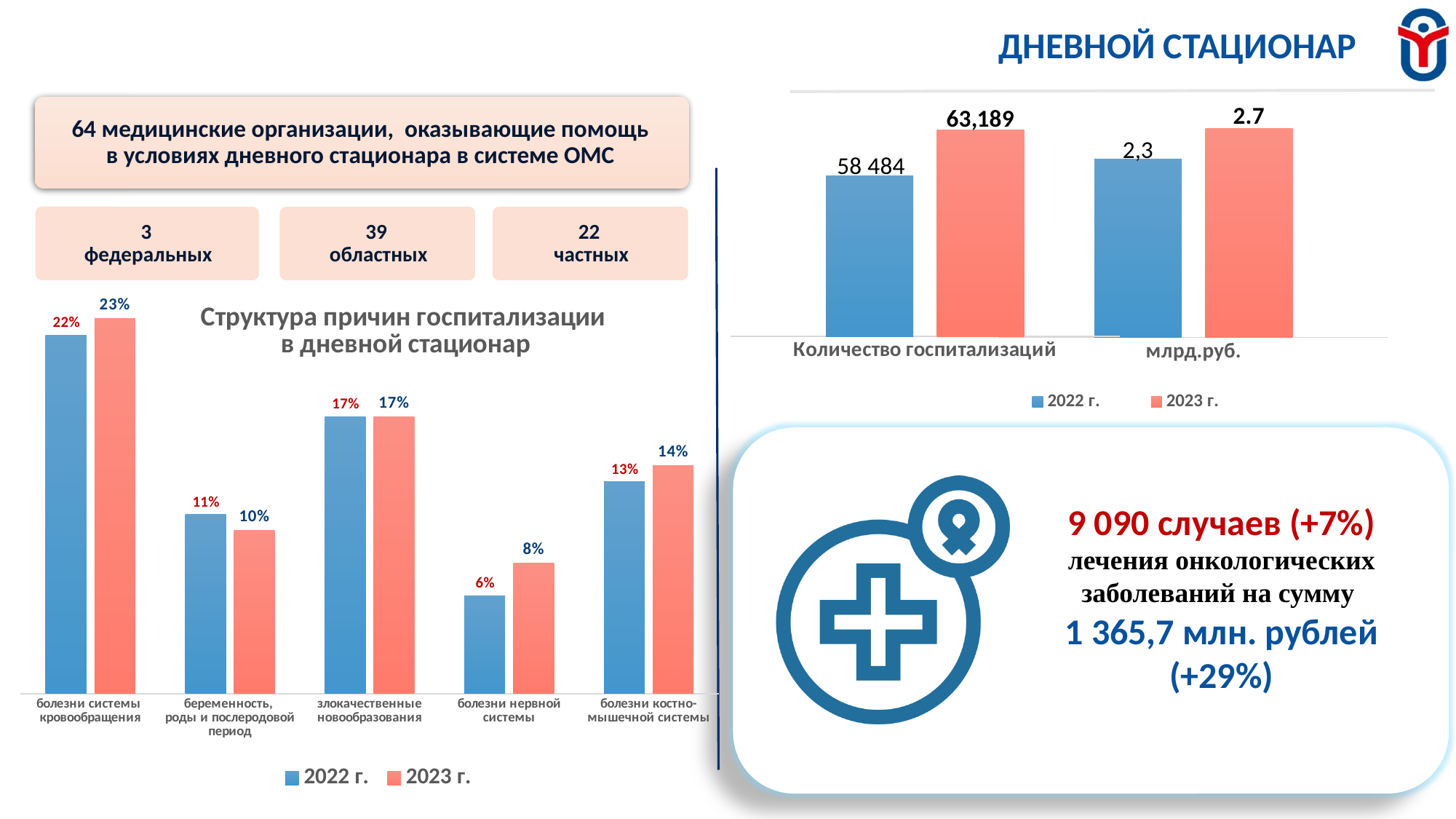
In the chart 'Структура причин госпитализации в дневной стационар', which category has the lowest 2022 г. value? болезни нервной системы In the chart 'Структура причин госпитализации в дневной стационар', which category has the highest 2023 г. value? болезни системы кровообращения How many categories are shown in the chart 'Структура причин госпитализации в дневной стационар'? 5 How many series does the legend list in the chart 'Структура причин госпитализации в дневной стационар'? 2 In the chart 'Структура причин госпитализации в дневной стационар', which is larger for болезни костно-мышечной системы: the 2022 г. value or the 2023 г. value? 2023 г. In the chart in the top right of the slide, which is larger for Количество госпитализаций: the 2022 г. value or the 2023 г. value? 2023 г. In the chart 'Структура причин госпитализации в дневной стационар', what is the 2023 г. value for болезни системы кровообращения? 23% In the chart 'Структура причин госпитализации в дневной стационар', what is the 2022 г. value for болезни нервной системы? 6% In the chart in the top right of the slide, what is the 2023 г. value for млрд.руб.? 2.7 In the chart in the top right of the slide, what is the 2022 г. value for Количество госпитализаций? 58 484 In the chart 'Структура причин госпитализации в дневной стационар', what is the difference between the 2022 г. and 2023 г. values for беременность, роды и послеродовой период? 1% What kind of chart is the chart in the top right of the slide? bar chart